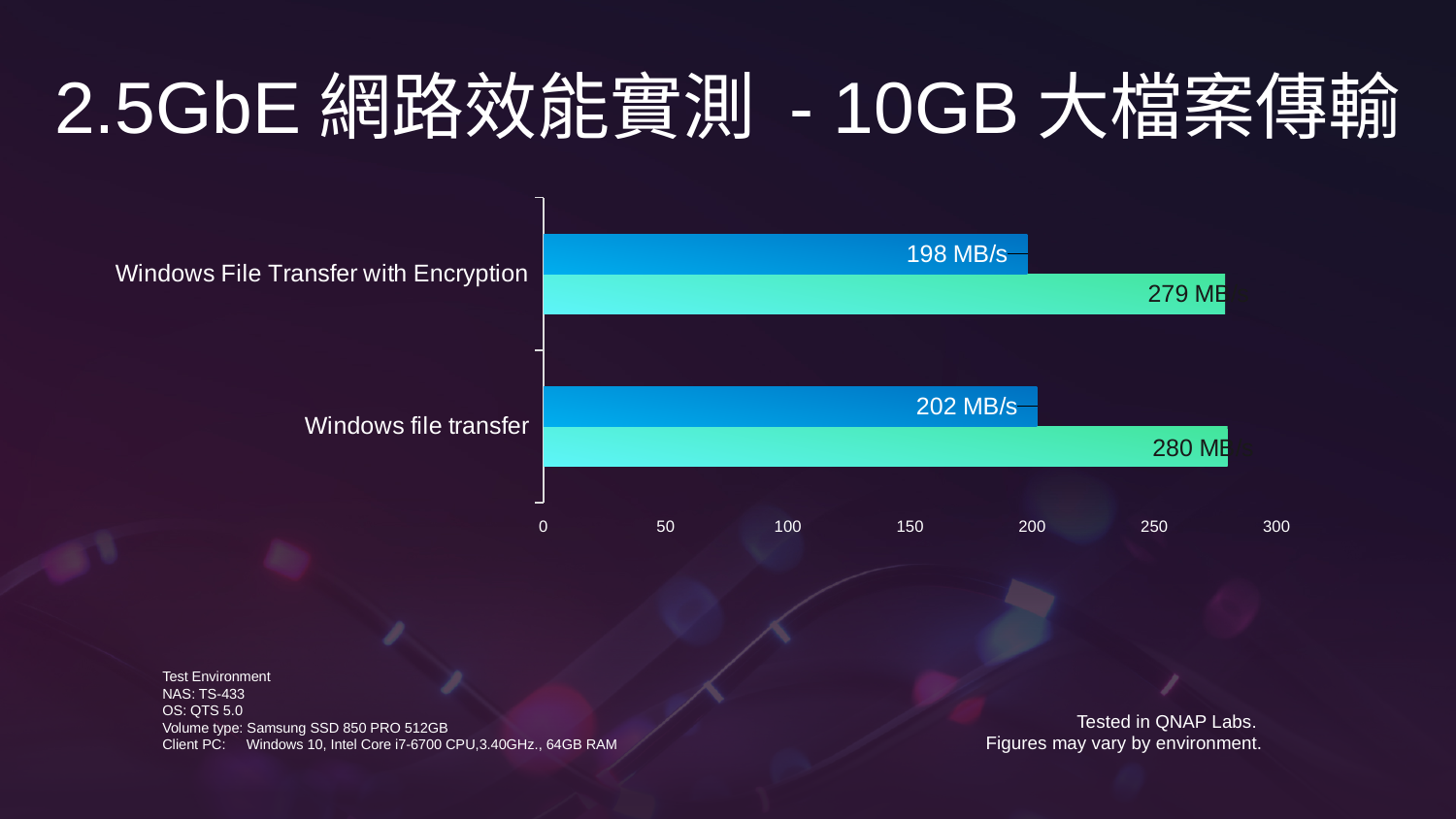
What is the difference between the blue bar values for Windows file transfer and Windows File Transfer with Encryption? 4 MB/s How many categories are shown on the chart? 2 Is the value of the cyan bar for Windows File Transfer with Encryption greater or less than 250? greater What is the interval between tick marks on the horizontal axis? 50 Is the value of the blue bar for Windows File Transfer with Encryption greater or less than 200? less Which category has the higher value for the blue bars, Windows file transfer or Windows File Transfer with Encryption? Windows file transfer What is the value of the blue bar for Windows file transfer? 202 MB/s Is the value of the cyan bar for Windows file transfer greater or less than 250? greater What kind of chart is shown on the slide? bar chart For Windows file transfer, which bar is longer, the blue bar or the cyan bar? the cyan bar What is the highest value shown on the horizontal axis of the chart? 300 What is the value of the blue bar for Windows File Transfer with Encryption? 198 MB/s